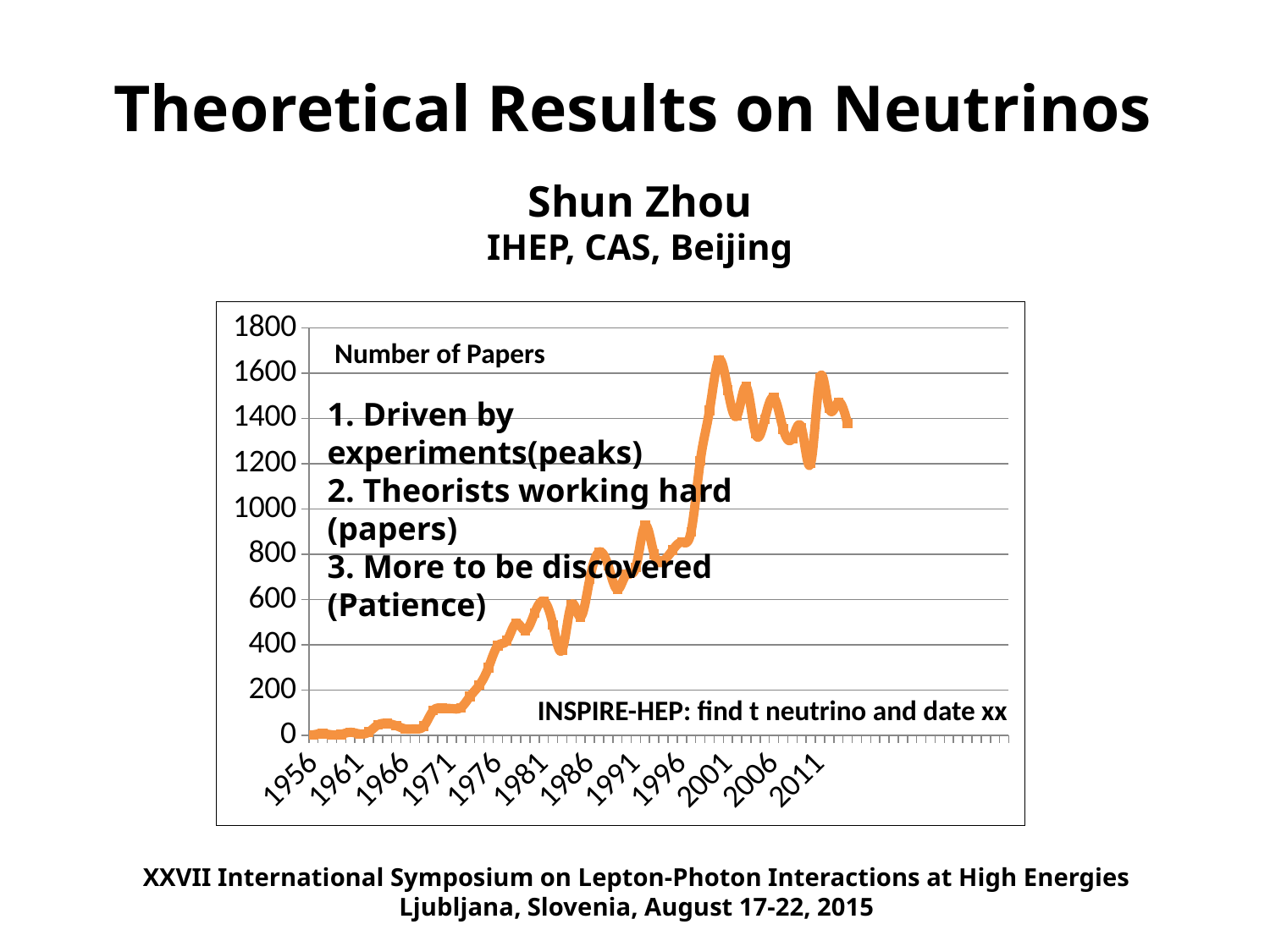
Is the value for 1991 greater or less than 600? greater Is the value for 2001 greater or less than 1400? greater Is the value for 2006 greater or less than 1000? greater What is the title shown inside the chart? Number of Papers Which is larger, the value for 1971 or the value for 2001? 2001 How many year labels are shown on the x axis? 12 What kind of chart is shown on the slide? line chart What is the first year label on the x axis? 1956 Overall, do the values rise or fall from 1956 to 2011? rise What is the highest value shown on the y axis? 1800